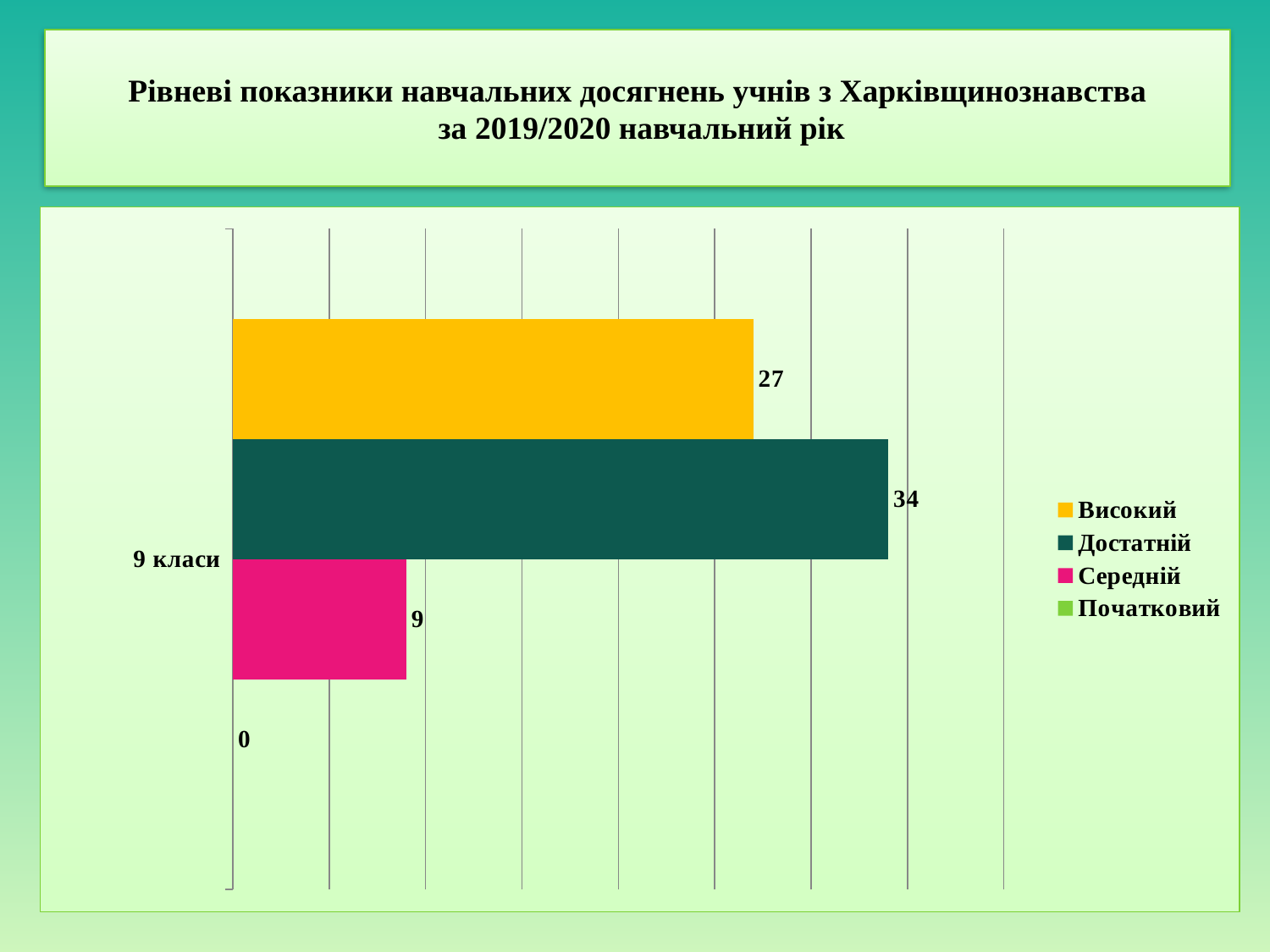
What is the value for Початковий for 9 класи? 0 What is the value for Достатній for 9 класи? 34 What is the value for Середній for 9 класи? 9 Which series has the highest value for 9 класи? Достатній What is the difference between the Високий and Середній values for 9 класи? 18 What is the difference between the Достатній and Високий values for 9 класи? 7 What is the value for Високий for 9 класи? 27 How many series does the legend list? 4 Which is larger for 9 класи, Високий or Середній? Високий What kind of chart is shown on the slide? Bar chart What colour is the bar for Достатній? Dark green Which series has the lowest value for 9 класи? Початковий